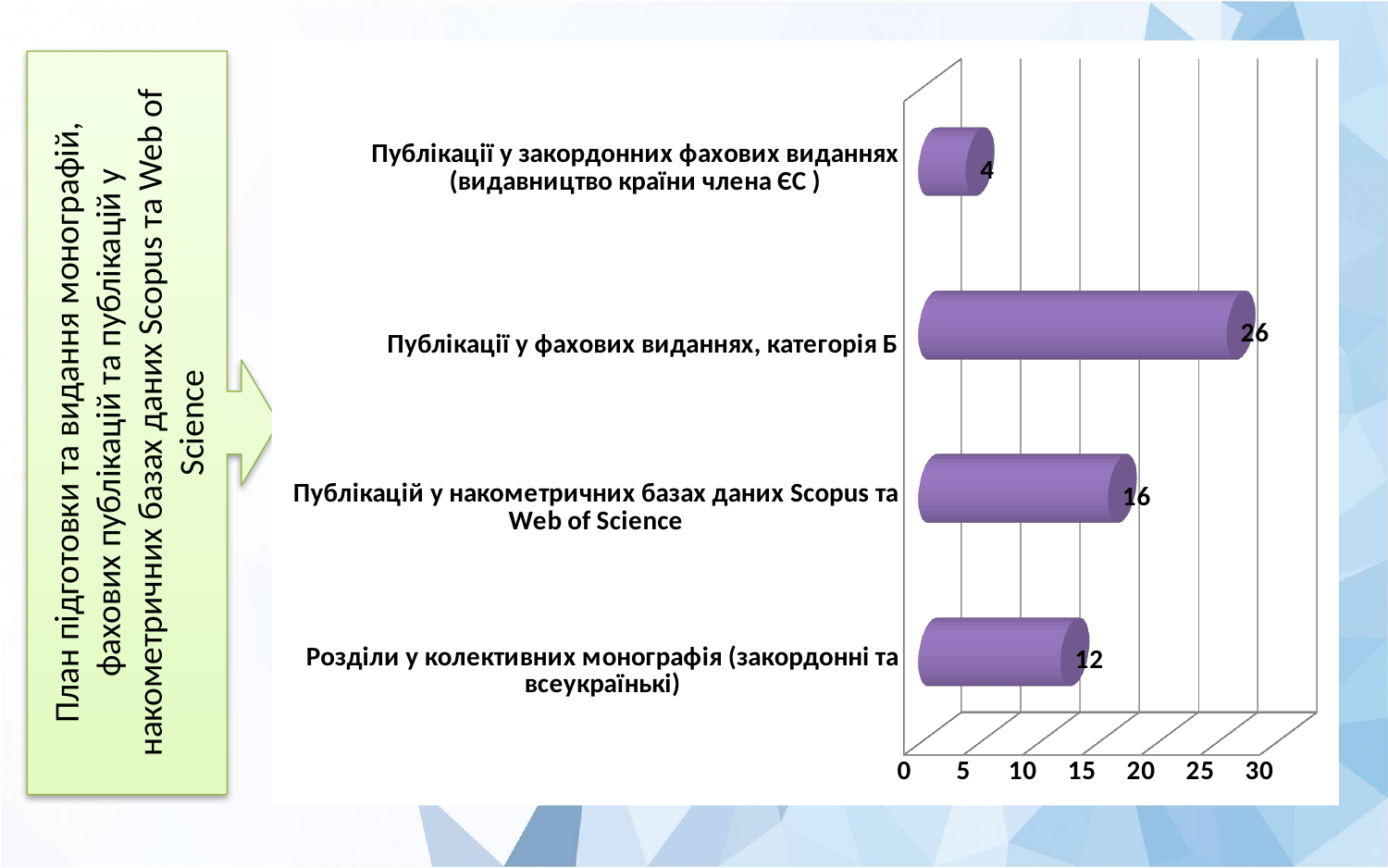
How many categories are shown in the chart? 4 Which category has the lowest value? Публікації у закордонних фахових виданнях (видавництво країни члена ЄС ) What kind of chart is shown on the slide? bar chart Is the value for 'Публікації у фахових виданнях, категорія Б' greater or less than 20? greater What is the value for 'Публікації у закордонних фахових виданнях (видавництво країни члена ЄС )'? 4 What is the difference between the value for 'Публікації у фахових виданнях, категорія Б' and the value for 'Публікацій у накометричних базах даних Scopus та Web of Science'? 10 Which is larger: the value for 'Публікацій у накометричних базах даних Scopus та Web of Science' or the value for 'Розділи у колективних монографія (закордонні та всеукраїнькі)'? Публікацій у накометричних базах даних Scopus та Web of Science What is the value for 'Розділи у колективних монографія (закордонні та всеукраїнькі)'? 12 What is the difference between the value for 'Розділи у колективних монографія (закордонні та всеукраїнькі)' and the value for 'Публікації у закордонних фахових виданнях (видавництво країни члена ЄС )'? 8 What is the value for 'Публікації у фахових виданнях, категорія Б'? 26 Which category has the highest value? Публікації у фахових виданнях, категорія Б What is the value for 'Публікацій у накометричних базах даних Scopus та Web of Science'? 16